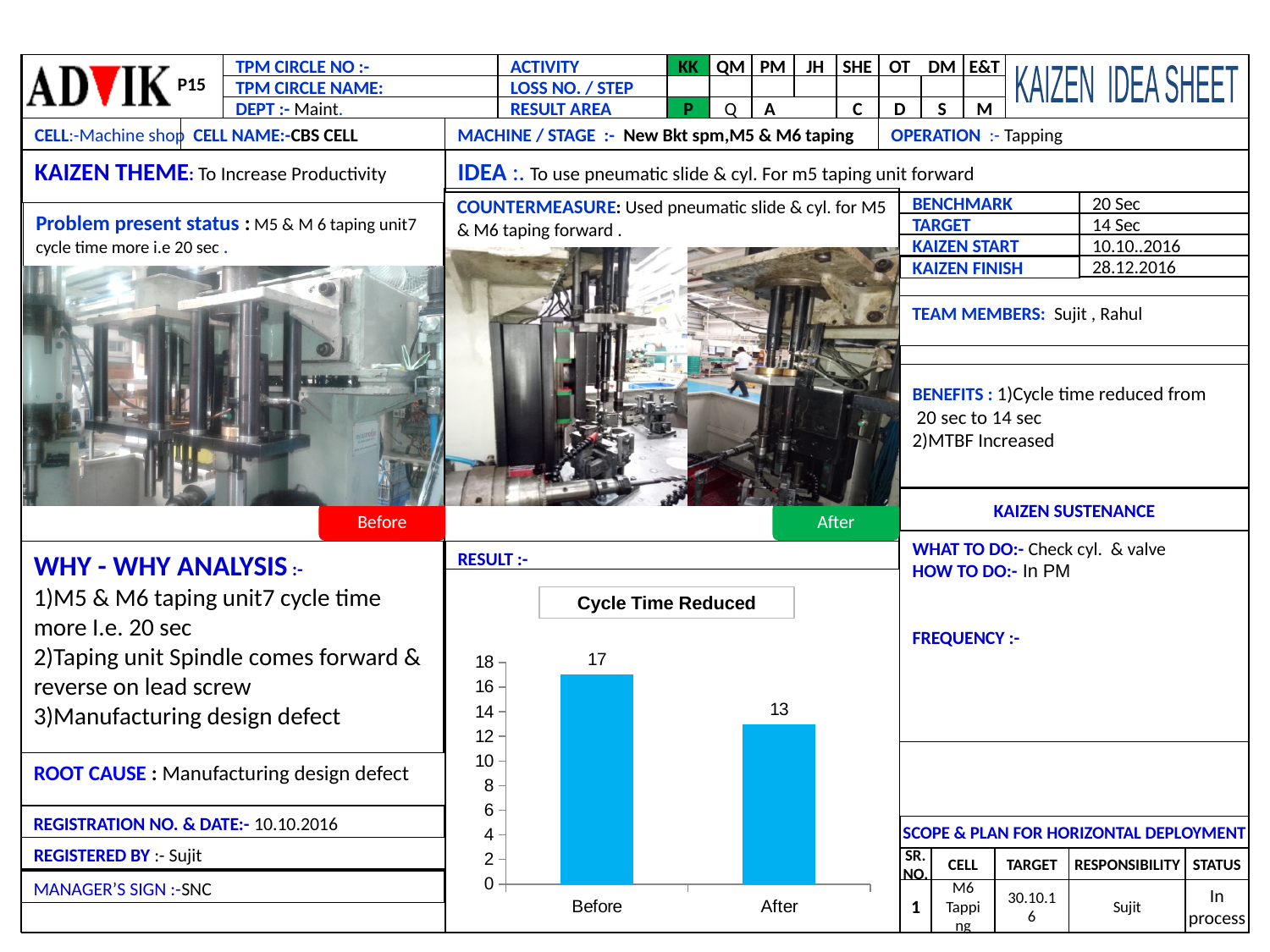
Is the value for Before in the Cycle Time Reduced chart greater or less than 16? greater Do the values in the Cycle Time Reduced chart rise or fall from Before to After? fall What is the value for After in the Cycle Time Reduced chart? 13 Is the value for After in the Cycle Time Reduced chart greater or less than 14? less How many categories are shown in the Cycle Time Reduced chart? 2 In the Cycle Time Reduced chart, which is larger, Before or After? Before Which category has the lowest value in the Cycle Time Reduced chart? After What is the title of the chart on the slide? Cycle Time Reduced What kind of chart is the Cycle Time Reduced chart? bar chart What is the value for Before in the Cycle Time Reduced chart? 17 Which category has the highest value in the Cycle Time Reduced chart? Before What is the difference between the Before and After values in the Cycle Time Reduced chart? 4